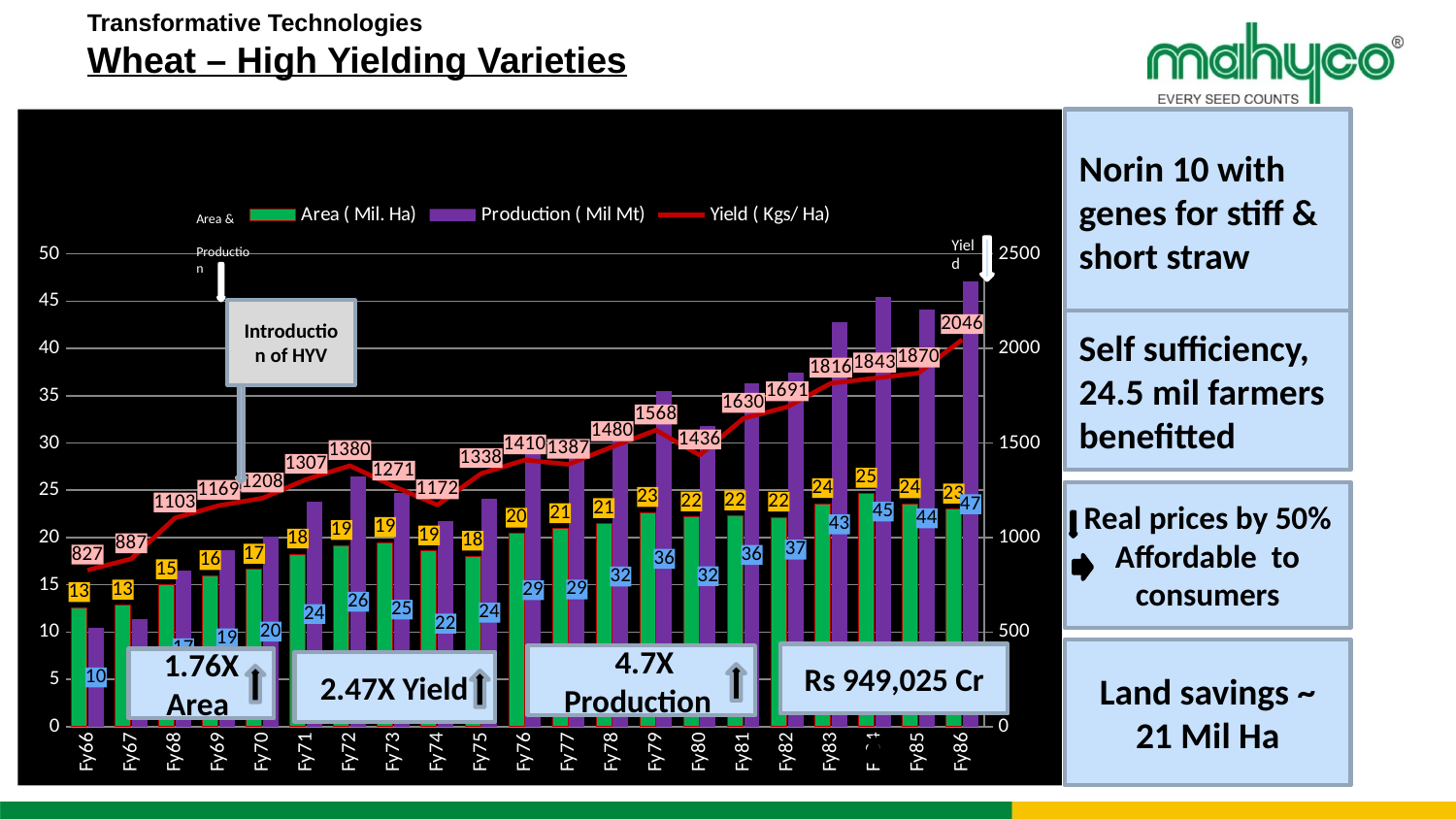
Which year has the lowest Yield (Kgs/Ha)? Fy66 What is the Yield (Kgs/Ha) value for Fy86? 2046 How many series does the legend list? 3 What is the difference between the Yield values for Fy86 and Fy66? 1219 Which year has the larger Production value, Fy72 or Fy74? Fy72 Which year has the highest Yield (Kgs/Ha)? Fy86 What is the Area (Mil. Ha) value for Fy66? 13 What is the difference between the Production values for Fy86 and Fy66? 37 What is the Production (Mil Mt) value for Fy86? 47 Does the Yield line generally rise or fall from Fy66 to Fy86? Rise What is the Area (Mil. Ha) value for Fy79? 23 What is the Yield (Kgs/Ha) value for Fy66? 827